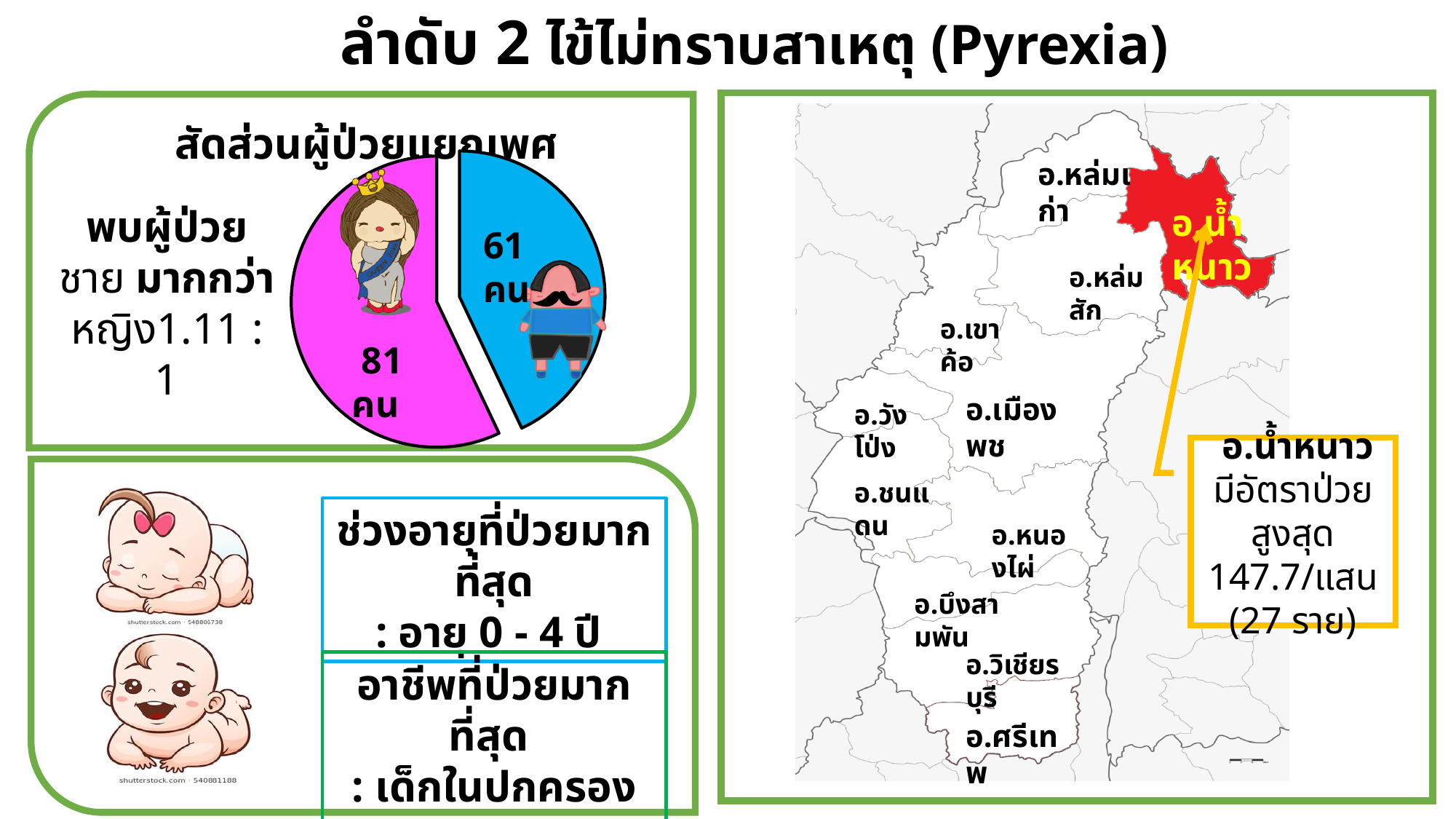
What is the total of the two values shown on the pie chart? 142 คน What kind of chart is shown in the top-left panel of the slide? pie chart Which slice of the pie chart is larger, the magenta one or the blue one? the magenta one What share of the pie chart does the blue slice (61 คน) represent? 43% What value is printed on the magenta (pink) slice of the pie chart? 81 คน What value is printed on the blue slice of the pie chart? 61 คน Which slice of the pie chart is the smallest? the blue slice (61 คน) What share of the pie chart does the magenta slice (81 คน) represent? 57% What is the title written above the pie chart? สัดส่วนผู้ป่วยแยกเพศ What is the difference between the two values shown on the pie chart? 20 คน How many slices does the pie chart have? 2